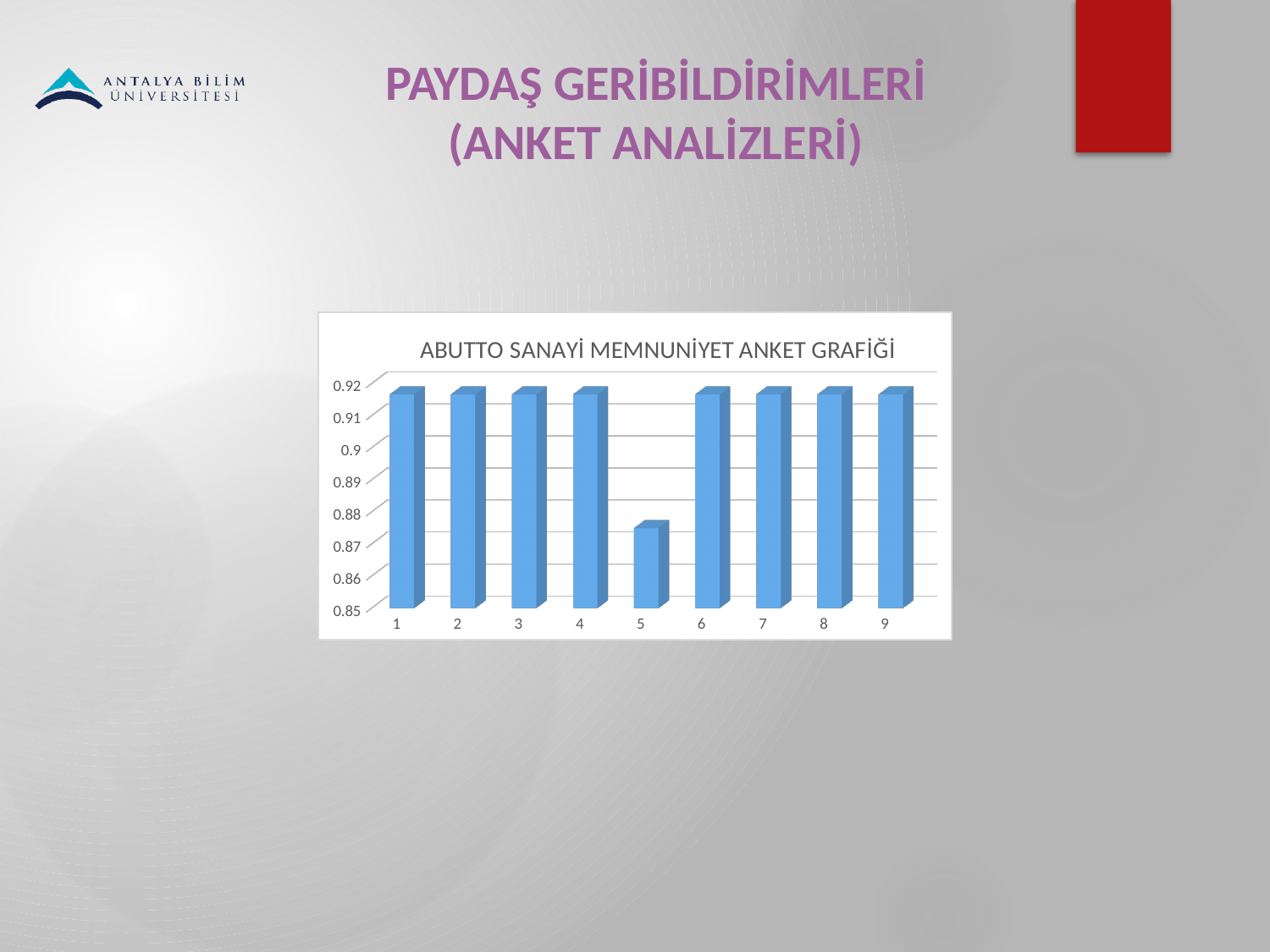
Is the value for category 1 greater or less than 0.91? greater Which is larger, the value for category 4 or the value for category 5? category 4 Is the value for category 9 greater or less than 0.9? greater What is the title of the chart? ABUTTO SANAYİ MEMNUNİYET ANKET GRAFİĞİ Which is larger, the value for category 5 or the value for category 6? category 6 What is the lowest value shown on the vertical axis of the chart? 0.85 What type of chart is shown on the slide? bar chart Is the value for category 5 greater or less than 0.88? less How many categories are plotted on the x axis of the chart? 9 Which category has the lowest value in the chart? 5